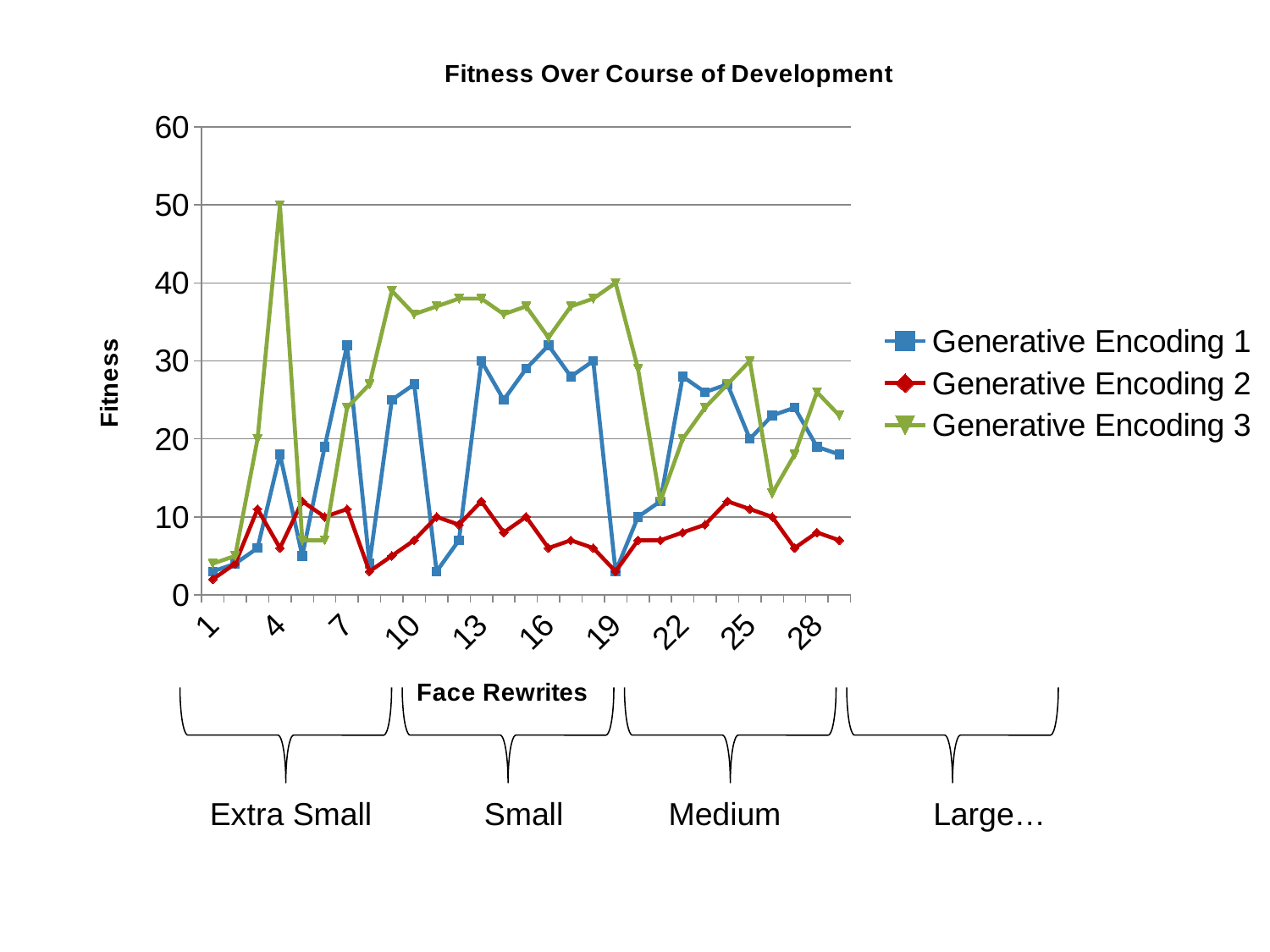
Is the value for Generative Encoding 3 at face rewrite 10 greater or less than 30? greater Which series reaches the highest fitness value on the chart? Generative Encoding 3 What kind of chart is shown on the slide? line chart What is the peak fitness value of Generative Encoding 3 at face rewrite 4? 50 Is the value for Generative Encoding 1 at face rewrite 19 greater or less than 10? less Is the value for Generative Encoding 2 at face rewrite 4 greater or less than 10? less What is the title of the chart? Fitness Over Course of Development Which series stays lowest across most of the chart? Generative Encoding 2 At face rewrite 16, which series has the larger value, Generative Encoding 1 or Generative Encoding 2? Generative Encoding 1 What is the label of the y axis? Fitness How many series does the legend list? 3